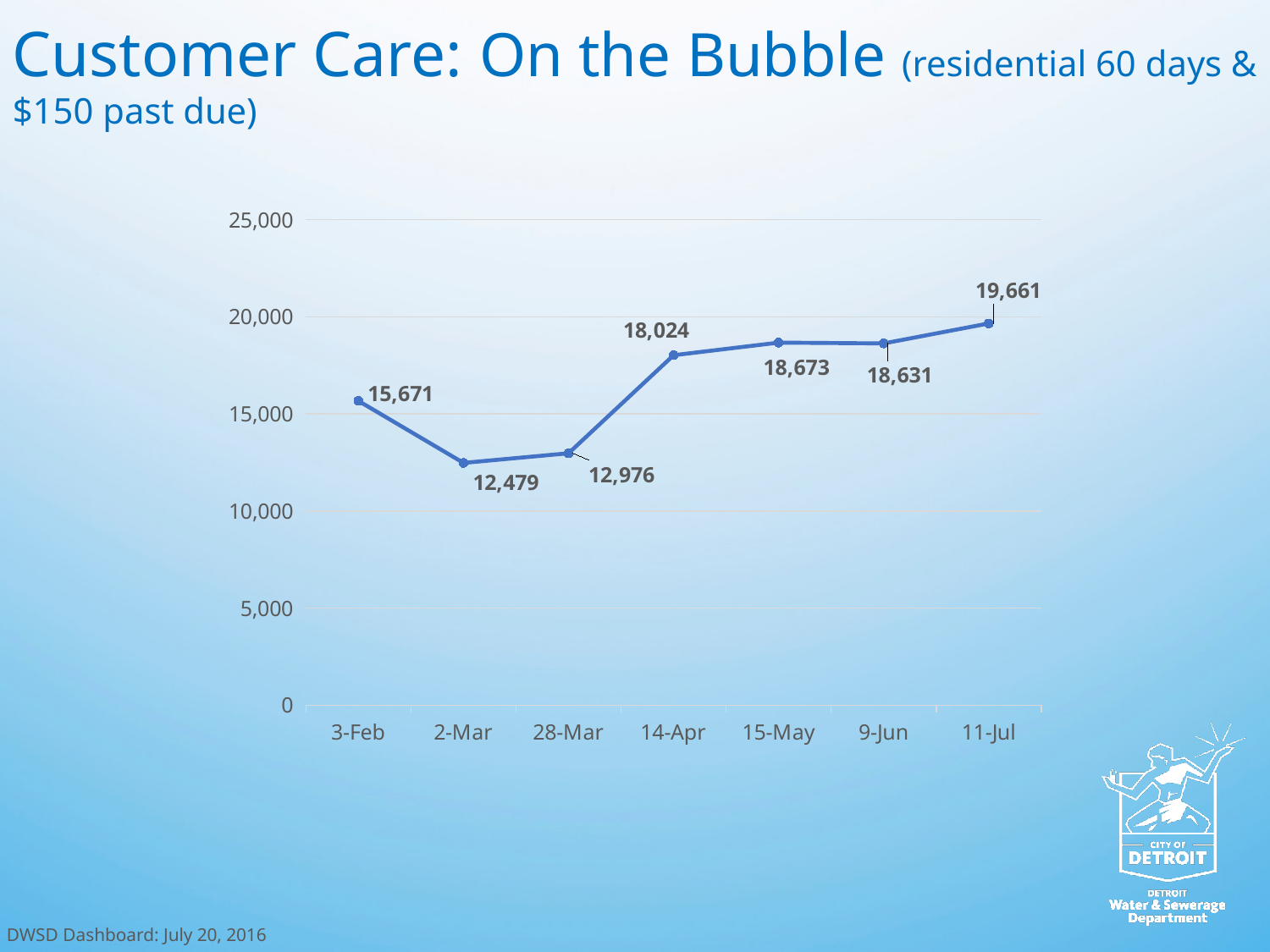
Which is larger, the value for 15-May or the value for 2-Mar? 15-May What is the difference between the values for 14-Apr and 28-Mar? 5,048 What is the value for 14-Apr? 18,024 How many data points are plotted on the chart? 7 Do the values rise or fall from 28-Mar to 11-Jul? rise Which date has the highest value? 11-Jul What is the difference between the values for 11-Jul and 3-Feb? 3,990 What kind of chart is shown on the slide? line chart Which date has the lowest value? 2-Mar Is the value for 9-Jun greater or less than 15,000? greater What is the value for 11-Jul? 19,661 What is the value for 3-Feb? 15,671